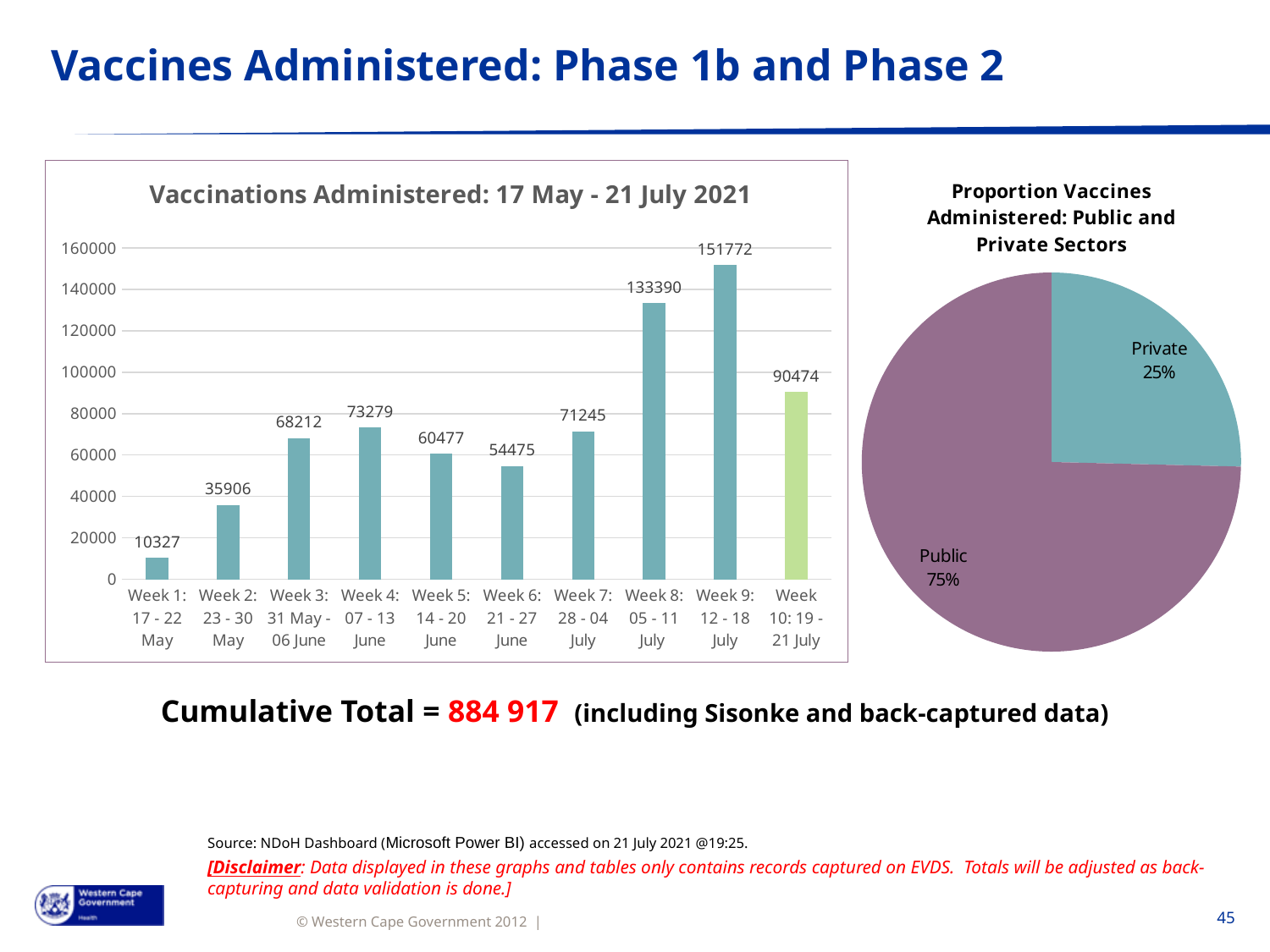
In the 'Vaccinations Administered: 17 May - 21 July 2021' chart, what is the value for Week 1: 17 - 22 May? 10327 In the 'Vaccinations Administered: 17 May - 21 July 2021' chart, which is larger, Week 4: 07 - 13 June or Week 5: 14 - 20 June? Week 4: 07 - 13 June What kind of chart is 'Vaccinations Administered: 17 May - 21 July 2021'? Bar chart In the 'Vaccinations Administered: 17 May - 21 July 2021' chart, what is the difference between Week 9: 12 - 18 July and Week 8: 05 - 11 July? 18382 What kind of chart is 'Proportion Vaccines Administered: Public and Private Sectors'? Pie chart In the 'Vaccinations Administered: 17 May - 21 July 2021' chart, which week has the lowest value? Week 1: 17 - 22 May How many weeks are shown in the 'Vaccinations Administered: 17 May - 21 July 2021' chart? 10 In the 'Proportion Vaccines Administered: Public and Private Sectors' pie chart, what share is Private? 25% In the 'Vaccinations Administered: 17 May - 21 July 2021' chart, which week has the highest value? Week 9: 12 - 18 July In the 'Vaccinations Administered: 17 May - 21 July 2021' chart, what is the value for Week 10: 19 - 21 July? 90474 In the 'Vaccinations Administered: 17 May - 21 July 2021' chart, is the value for Week 8: 05 - 11 July greater or less than 120000? greater In the 'Vaccinations Administered: 17 May - 21 July 2021' chart, what is the value for Week 9: 12 - 18 July? 151772